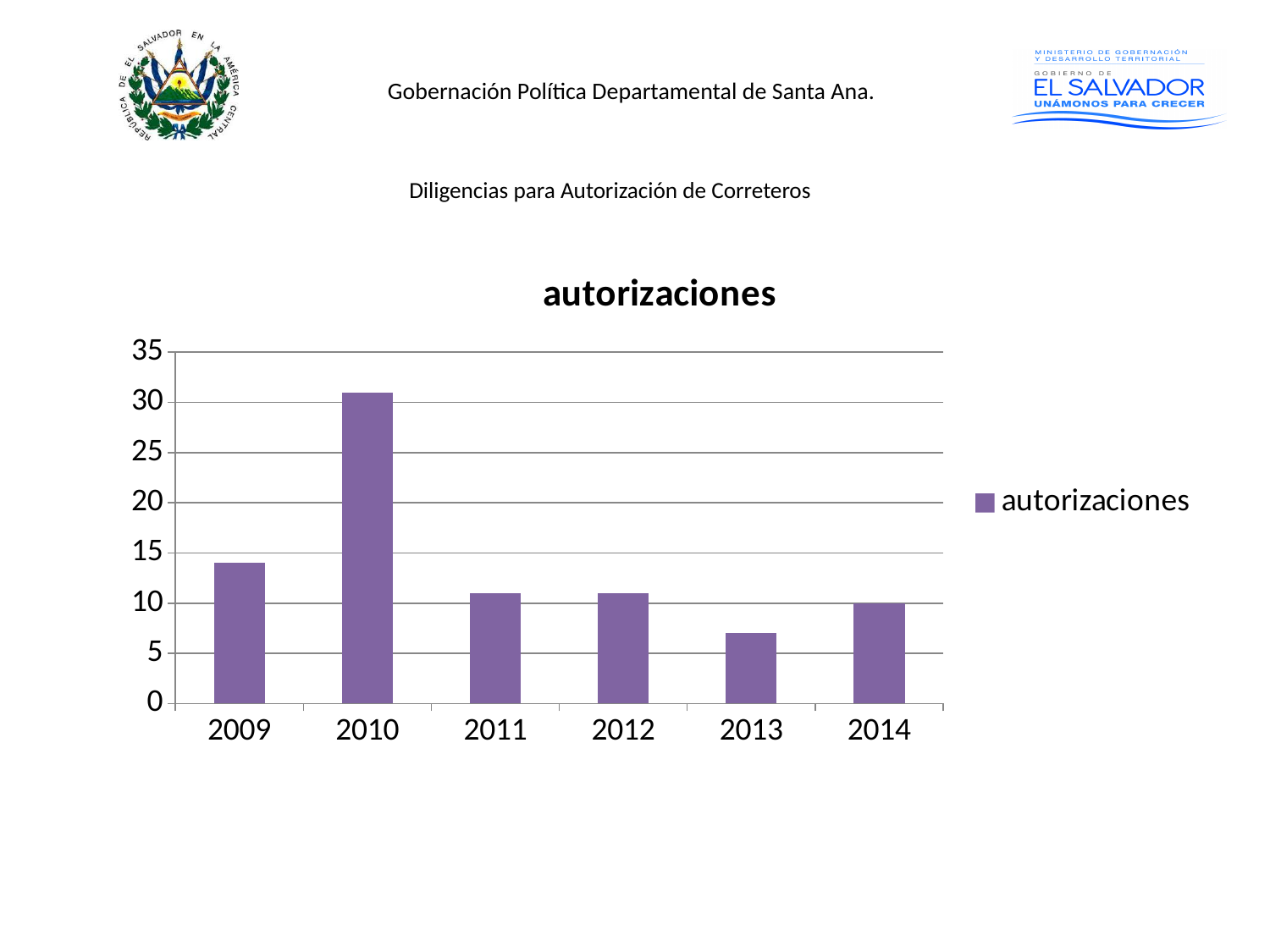
How many series does the legend list? 1 What is the title of the chart? autorizaciones Is the value for 2010 greater or less than 30? greater Is the value for 2009 greater or less than 15? less What type of chart is shown on the slide? bar chart Which year has the lowest number of autorizaciones? 2013 Which year has the highest number of autorizaciones? 2010 From 2010 to 2013, do the values rise or fall? fall Which year has a larger value, 2009 or 2010? 2010 Is the value for 2013 greater or less than 5? greater How many years are shown on the x axis of the chart? 6 What is the value for 2014? 10